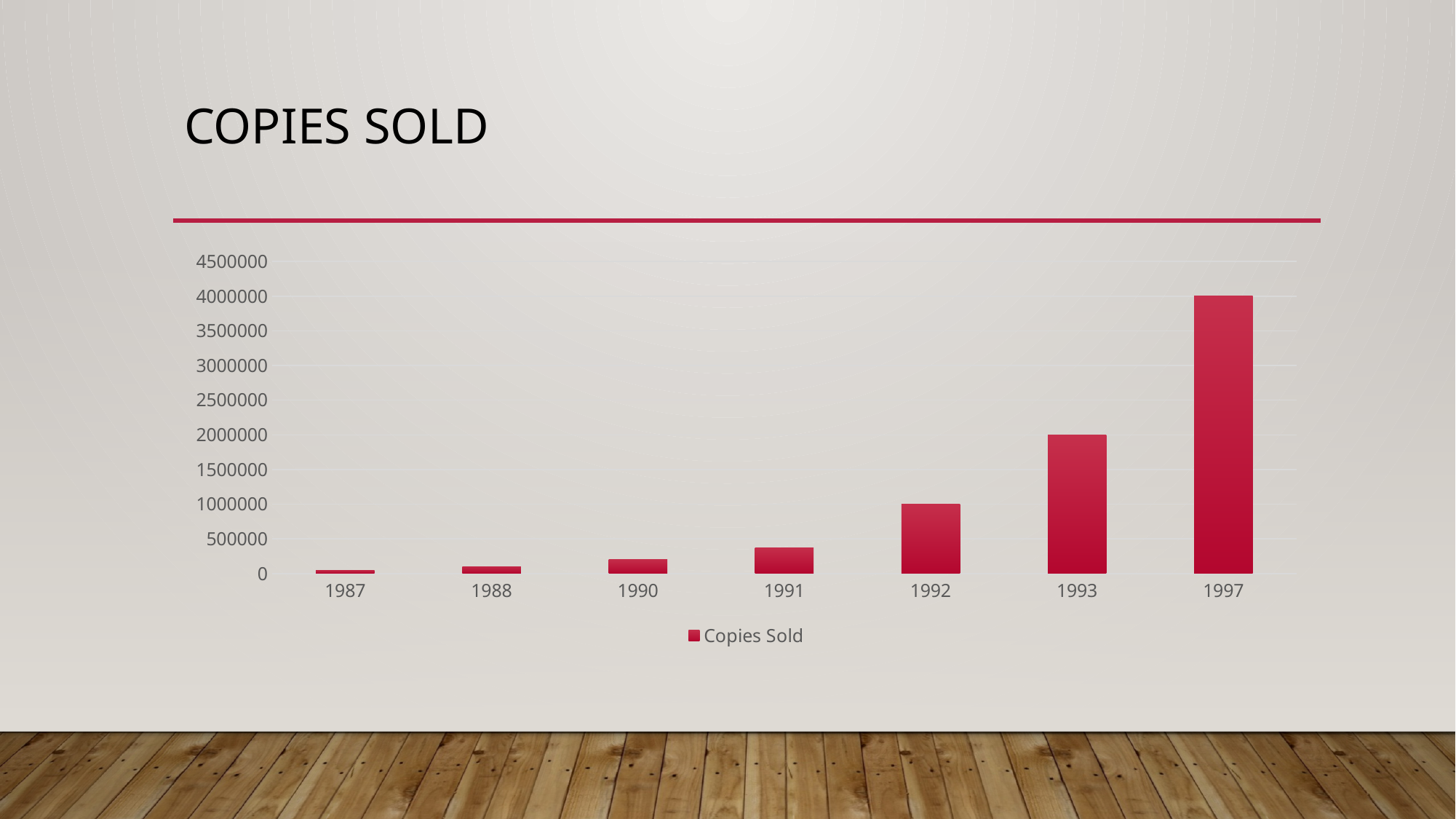
Which year has the lowest number of copies sold? 1987 How many years are shown on the x axis of the chart? 7 How many copies were sold in 1992? 1000000 Which year has the highest number of copies sold? 1997 What kind of chart is shown on the slide? Bar chart What is the difference in copies sold between 1997 and 1993? 2000000 Do the values rise or fall from 1987 to 1997? Rise Is the value for 1991 greater or less than 500000? less Which year had more copies sold, 1991 or 1992? 1992 How many copies were sold in 1993? 2000000 How many series does the legend list? 1 How many copies were sold in 1997? 4000000